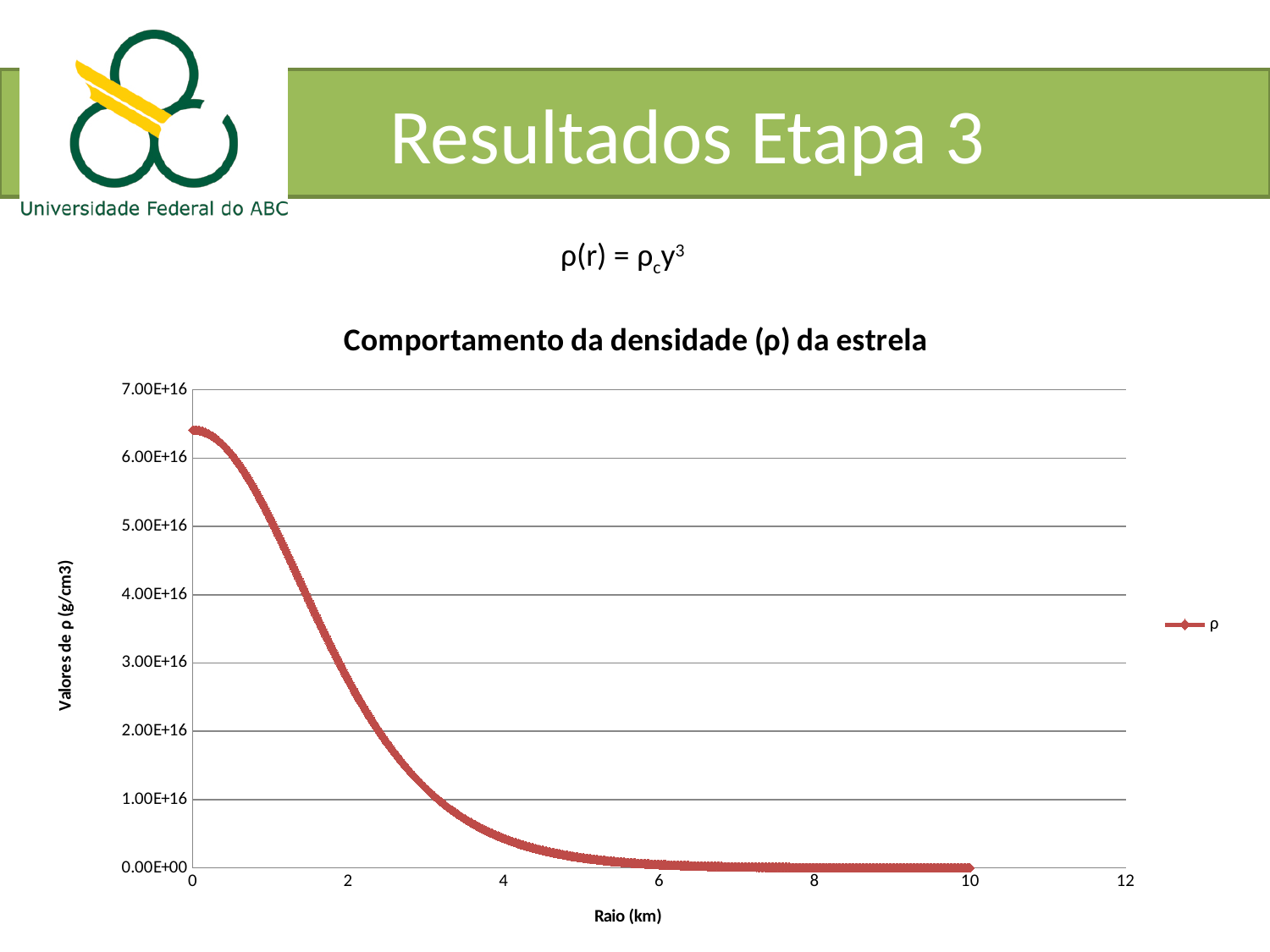
Is the value of ρ at radius 1 greater or less than 4.00E+16? greater Which is larger, the value of ρ at radius 2 or at radius 6? radius 2 Is the value of ρ at radius 3 greater or less than 2.00E+16? less Is the value of ρ at radius 2 greater or less than 4.00E+16? less At which radius is the density ρ highest? 0 What is the title of the chart? Comportamento da densidade (ρ) da estrela What is the name of the series shown in the legend? ρ Do the values of ρ rise or fall as the radius increases along the x axis? fall How many series does the legend list? 1 What kind of chart is shown on the slide? line chart